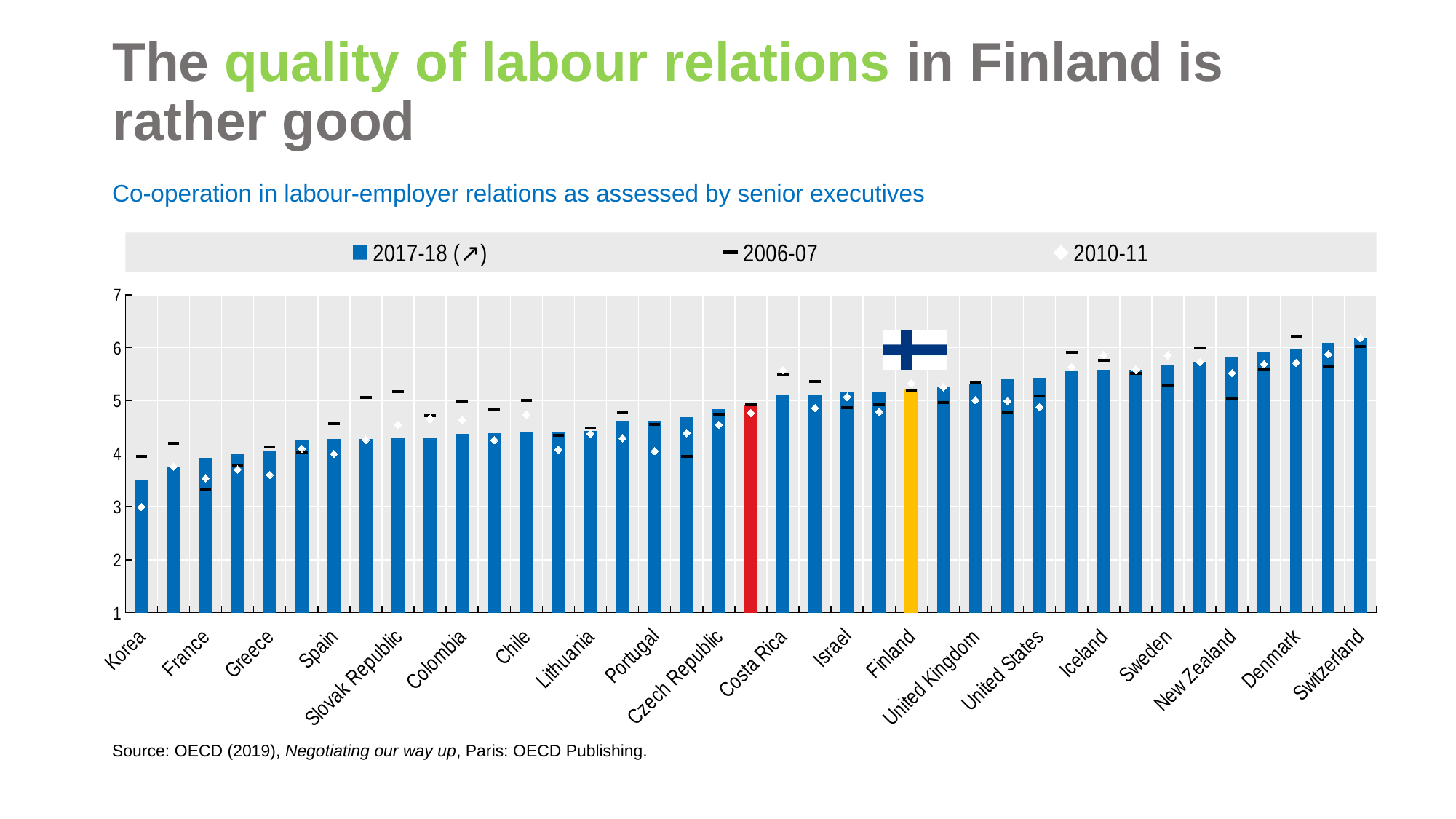
Is the 2017-18 value for Switzerland greater or less than 6? greater Is the 2017-18 value for Finland greater or less than 5? greater What colour is the bar for Finland? Yellow How many series does the legend list? 3 Which labelled country has the lowest 2017-18 bar? Korea Which has the larger 2017-18 value, Finland or Korea? Finland Is the 2017-18 value for Iceland greater or less than 5? greater Do the 2017-18 bars rise or fall from left to right along the x axis? Rise Which labelled country has the highest 2017-18 bar? Switzerland What kind of chart is shown on the slide? Bar chart